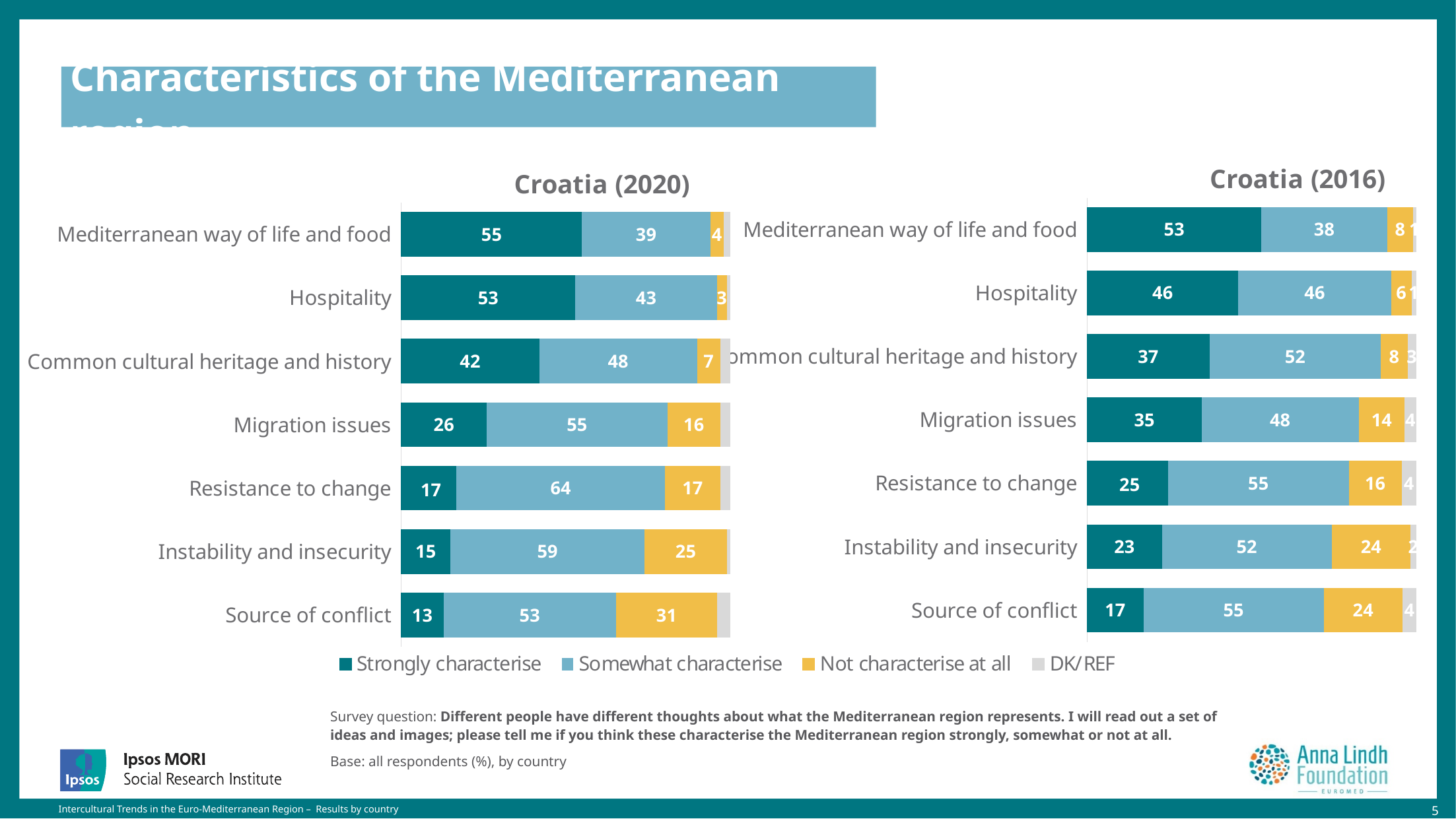
In the Croatia (2020) chart, which category has the lowest 'Strongly characterise' value? Source of conflict In the Croatia (2016) chart, what is the 'Somewhat characterise' value for 'Common cultural heritage and history'? 52 In the Croatia (2020) chart, what is the 'Not characterise at all' value for 'Source of conflict'? 31 Which is larger: the 'Strongly characterise' value for 'Migration issues' in the Croatia (2020) chart or in the Croatia (2016) chart? Croatia (2016) In the Croatia (2020) chart, which category has the highest 'Strongly characterise' value? Mediterranean way of life and food In the Croatia (2016) chart, which category has the highest 'Not characterise at all' value? Instability and insecurity and Source of conflict (both 24) What type of chart is the Croatia (2016) chart? Stacked bar chart In the Croatia (2020) chart, what percentage say 'Mediterranean way of life and food' strongly characterises the region? 55 In the Croatia (2020) chart, what is the difference between the 'Somewhat characterise' values for 'Resistance to change' and 'Migration issues'? 9 How many series does the legend list? 4 In the Croatia (2016) chart, what is the difference between the 'Strongly characterise' and 'Somewhat characterise' values for 'Hospitality'? 0 How many categories are shown in the Croatia (2020) chart? 7